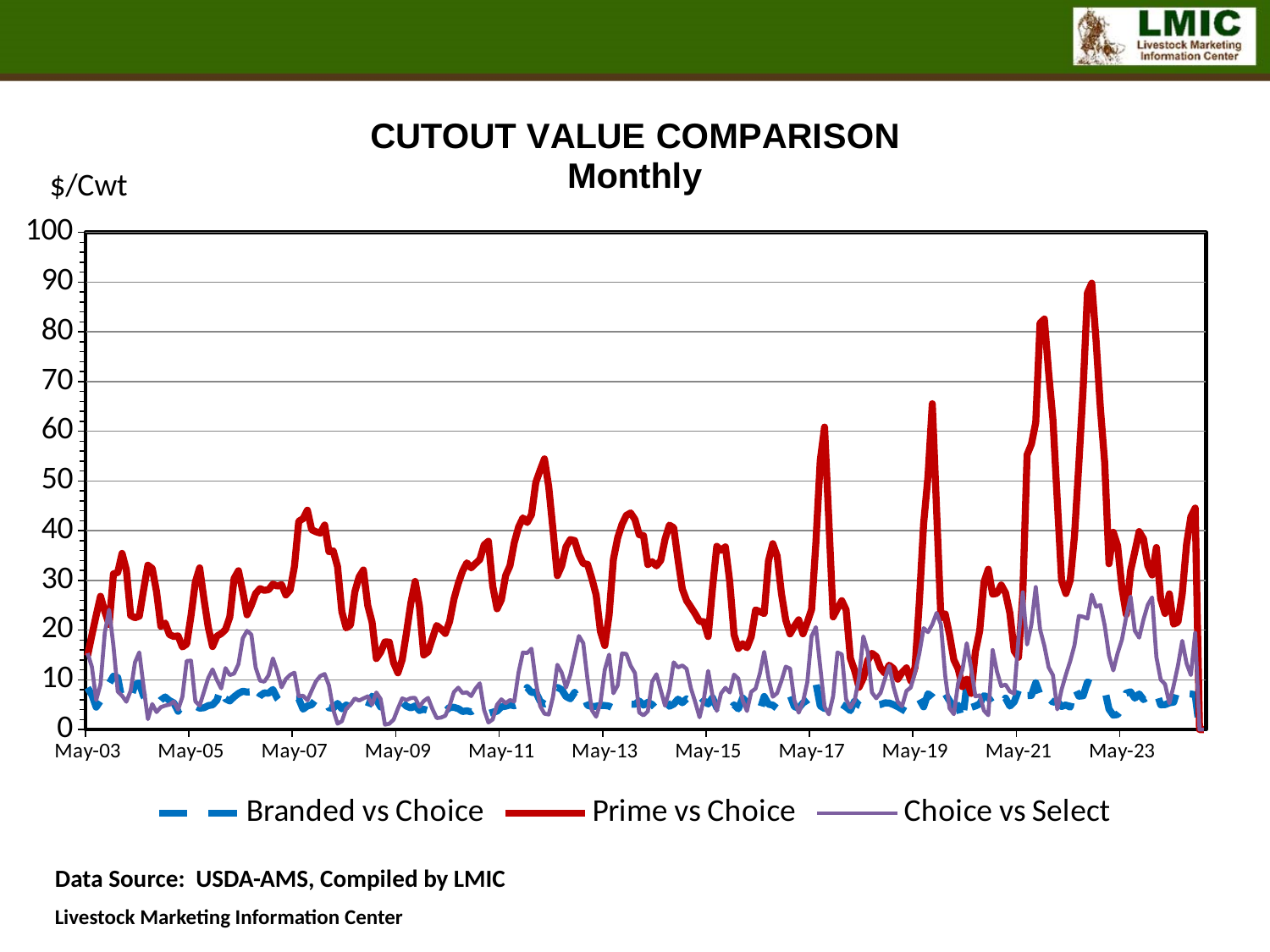
What is the first date label on the horizontal axis? May-03 What is the title of the chart? CUTOUT VALUE COMPARISON Monthly How many year labels are shown on the horizontal axis? 11 How many series does the legend list? 3 Which series stays lowest across most of the chart? Branded vs Choice Which series reaches the highest value on the chart? Prime vs Choice What unit is shown on the vertical axis of the chart? $/Cwt Is the highest value of the Choice vs Select series greater or less than 40? less Around May-21, which is larger: Prime vs Choice or Branded vs Choice? Prime vs Choice Is the peak value of the Prime vs Choice series greater or less than 80? greater Is the Branded vs Choice series ever greater than 20 on the chart? No What kind of chart is shown on the slide? Line chart